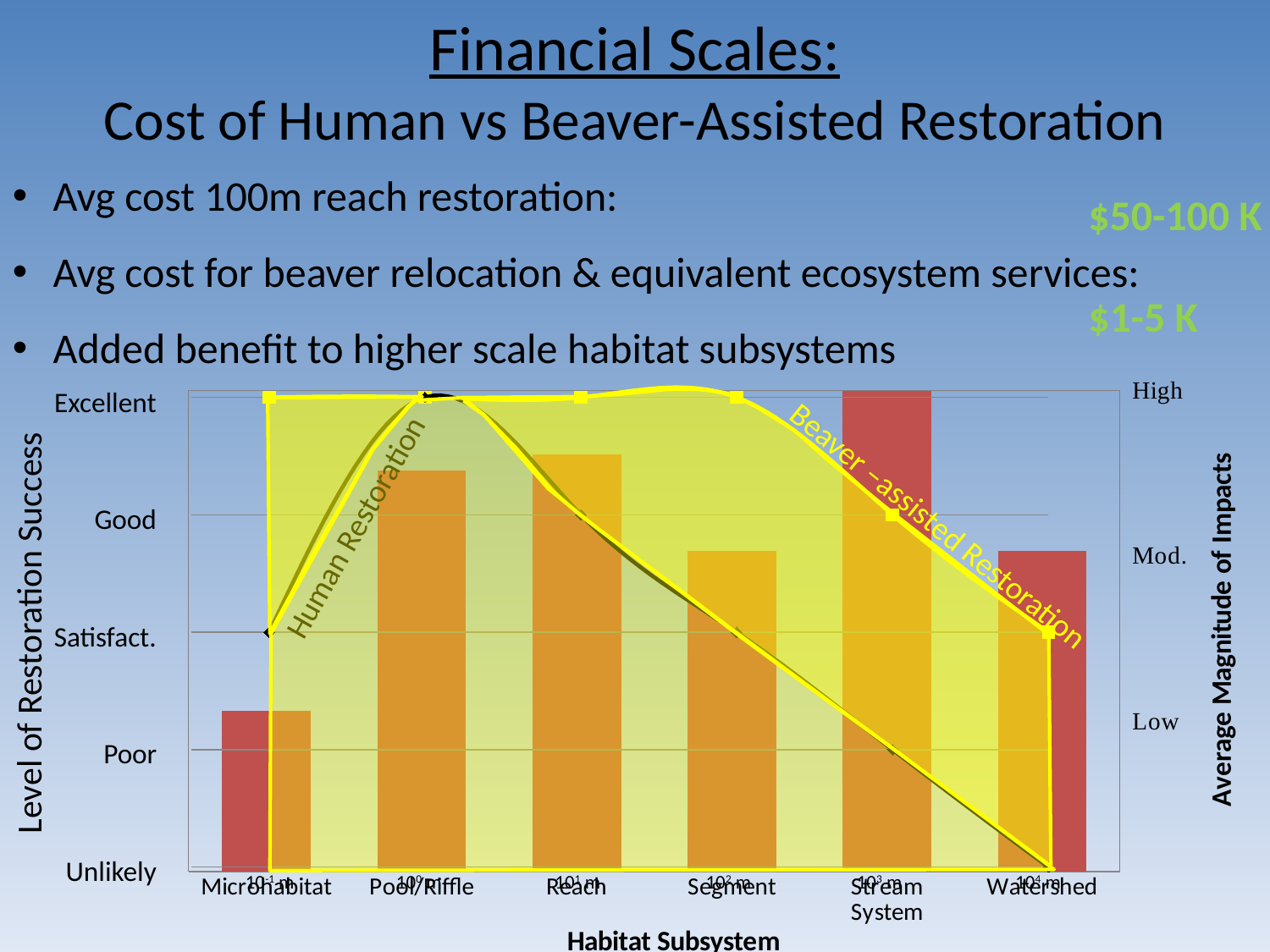
Which bar is taller, Reach or Segment? Reach Which bar is taller, Stream System or Watershed? Stream System How many habitat subsystem categories are shown on the x axis? 6 Which line is higher at Stream System, Human Restoration or Beaver-assisted Restoration? Beaver-assisted Restoration What is the title of the x axis? Habitat Subsystem What kind of chart is shown on the slide? A bar chart combined with line series What is the title of the left y axis? Level of Restoration Success Which habitat subsystem has the shortest bar for Average Magnitude of Impacts? Microhabitat What level of restoration success does the Human Restoration line reach at Watershed? Unlikely Does the Human Restoration line rise or fall from Pool/Riffle to Watershed? Fall Which habitat subsystem has the tallest bar for Average Magnitude of Impacts? Stream System What level of restoration success does the Beaver-assisted Restoration line show at Stream System? Good